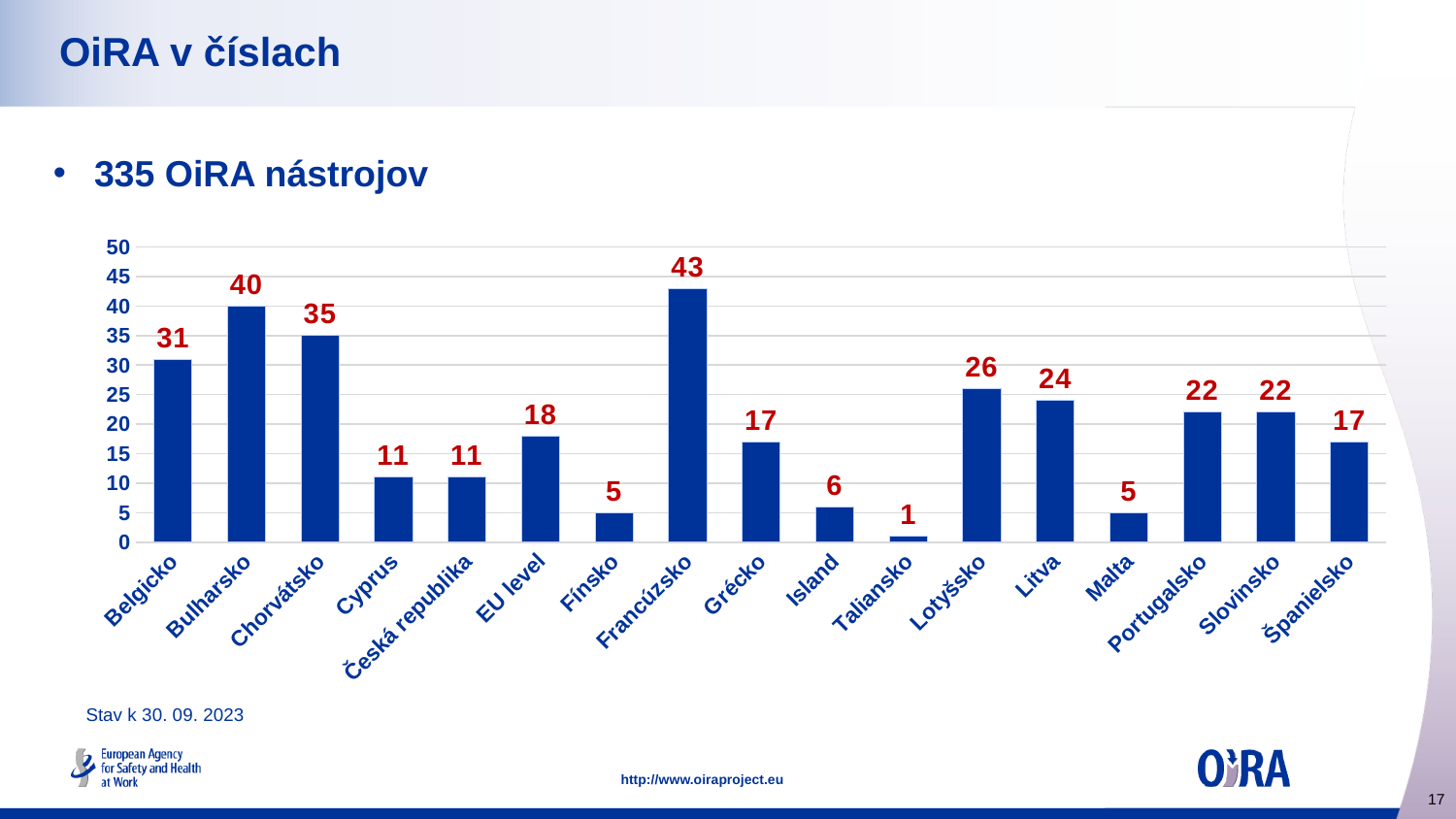
Which is larger, the value for Litva or the value for Portugalsko? Litva What is the difference between the values for Francúzsko and Taliansko? 42 How many categories are shown on the x axis? 17 What is the value for Lotyšsko? 26 Which category has the highest value? Francúzsko What is the value for EU level? 18 What kind of chart is shown on the slide? bar chart What is the difference between the values for Bulharsko and Chorvátsko? 5 Which category has the lowest value? Taliansko What is the value for Francúzsko? 43 Is the value for Belgicko greater or less than 30? greater What is the maximum value shown on the y axis? 50